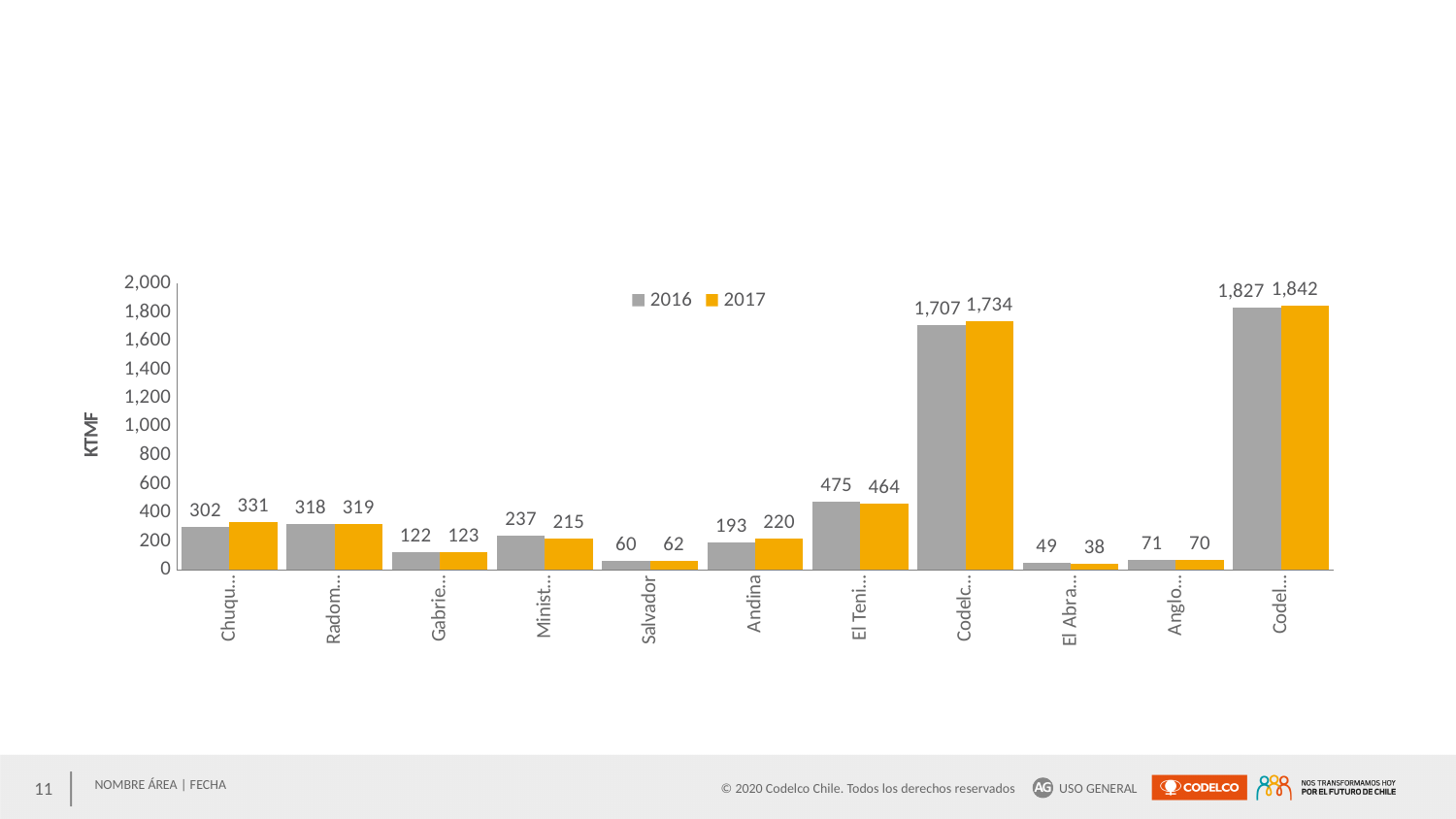
How many categories are shown on the x axis? 11 What is the label on the y axis? KTMF What kind of chart is shown on the slide? bar chart What is the highest 2017 value shown in the chart? 1,842 What is the 2016 value for Salvador? 60 What is the 2016 value for Andina? 193 Which has the larger 2016 value, Andina or Salvador? Andina By how much did the value for Andina increase from 2016 to 2017? 27 What is the 2017 value for Andina? 220 How many series does the legend list? 2 What is the lowest 2016 value shown in the chart? 49 What is the 2017 value for Salvador? 62